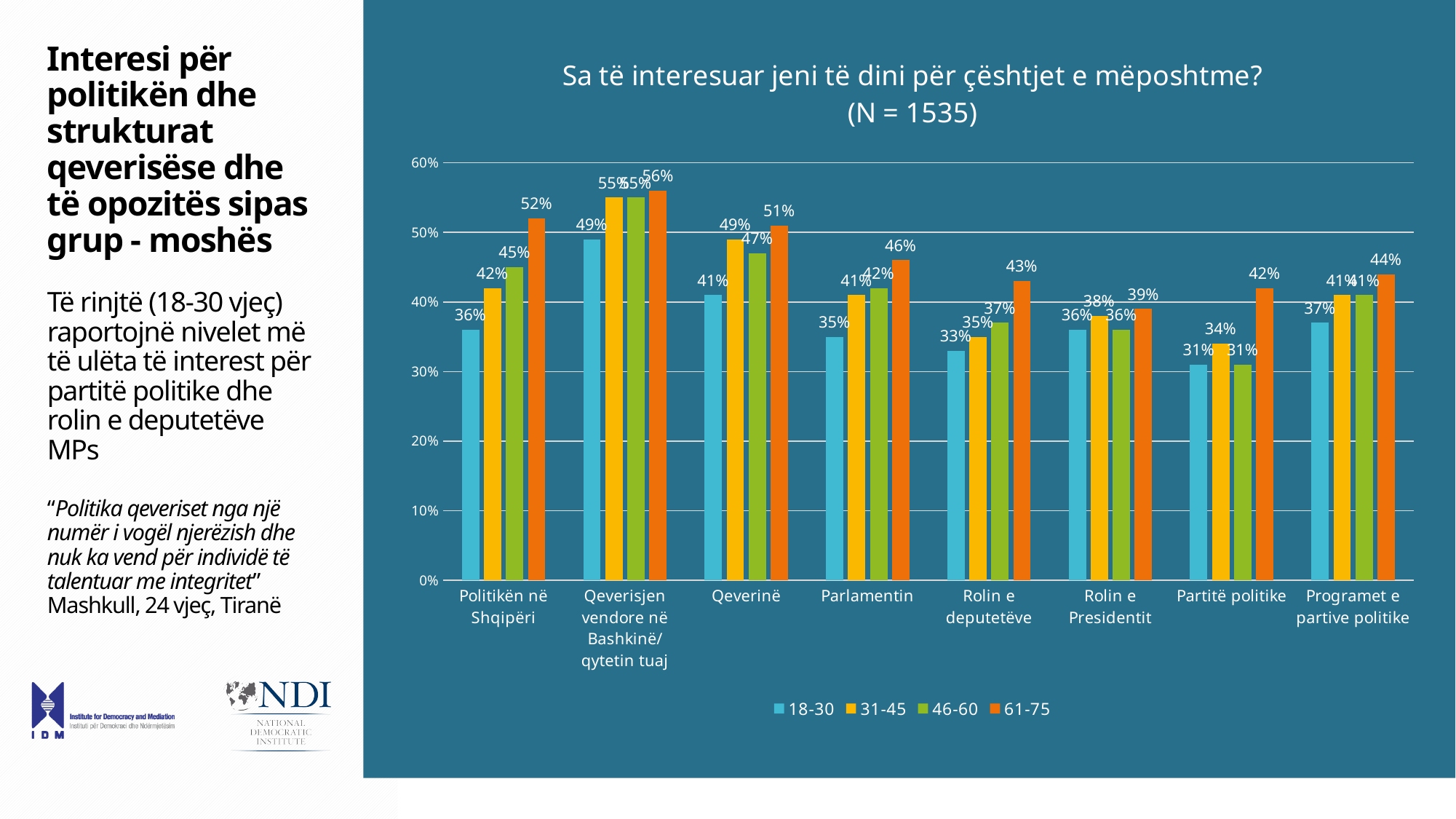
Is the value for the 18-30 group for Qeverisjen vendore në Bashkinë/qytetin tuaj greater or less than 40%? greater What sample size (N) is given in the chart title? 1535 Which category has the lowest value for the 18-30 group? Partitë politike What is the difference between the 61-75 and 18-30 values for Politikën në Shqipëri? 16% What type of chart is shown on the slide? bar chart What is the value for the 18-30 group for Politikën në Shqipëri? 36% How many categories are shown on the x axis? 8 How many series does the legend list? 4 Which is larger for Rolin e deputetëve: the 46-60 value or the 61-75 value? 61-75 What is the value for the 31-45 group for Qeverinë? 49% What is the value for the 61-75 group for Qeverisjen vendore në Bashkinë/qytetin tuaj? 56% Which age group has the highest value for Partitë politike? 61-75